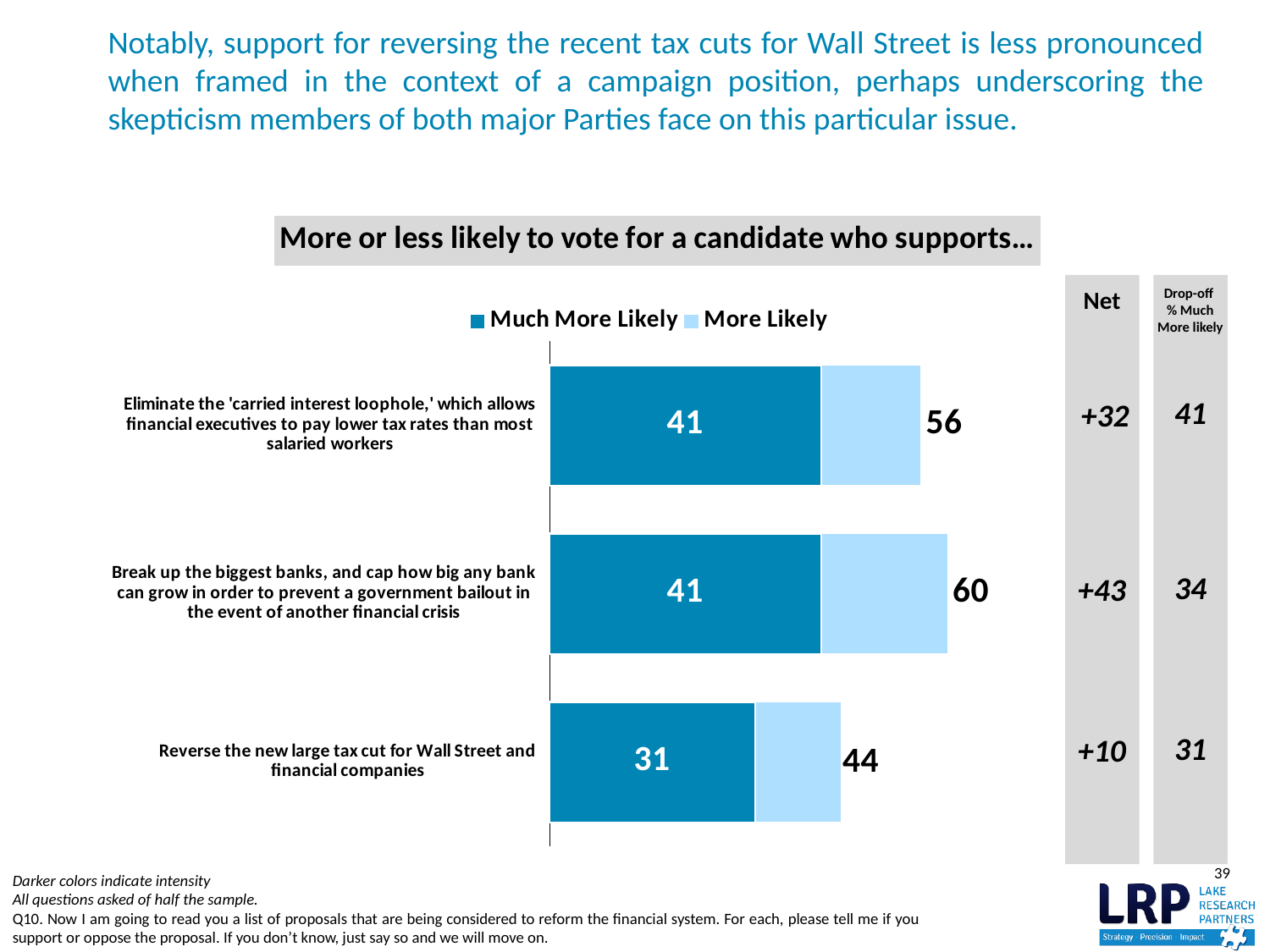
What is the 'Much More Likely' value for 'Break up the biggest banks, and cap how big any bank can grow in order to prevent a government bailout in the event of another financial crisis'? 41 What is the title of the chart? More or less likely to vote for a candidate who supports… Which proposal has the lowest 'Much More Likely' value? Reverse the new large tax cut for Wall Street and financial companies What is the 'Much More Likely' value for 'Reverse the new large tax cut for Wall Street and financial companies'? 31 What is the difference between the total for 'Break up the biggest banks' and the total for 'Reverse the new large tax cut for Wall Street'? 16 What is the total (Much More Likely plus More Likely) for 'Eliminate the carried interest loophole'? 56 What type of chart is shown on the slide? bar chart How many series does the chart legend list? 2 What is the total (Much More Likely plus More Likely) for 'Break up the biggest banks'? 60 How many proposals (categories) are shown in the chart? 3 Which proposal has the highest total of Much More Likely plus More Likely? Break up the biggest banks, and cap how big any bank can grow in order to prevent a government bailout in the event of another financial crisis Which is larger: the total for 'Eliminate the carried interest loophole' or the total for 'Reverse the new large tax cut for Wall Street'? Eliminate the carried interest loophole